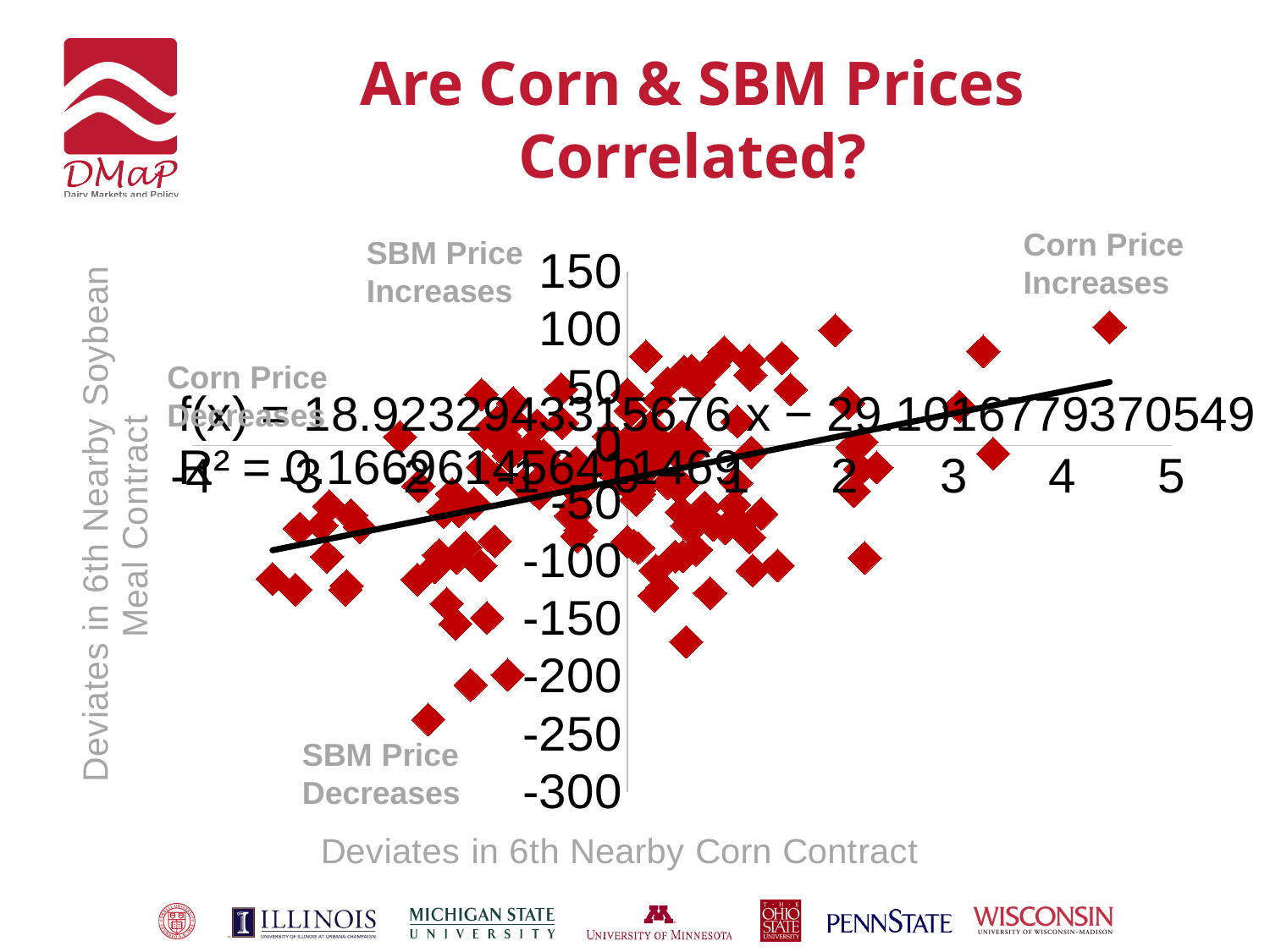
Is the trendline value at x = 4 greater or less than 0? greater Does the fitted trendline on the chart rise or fall as the x-axis value increases? rise Is the trendline value at x = -4 greater or less than 0? less What is the highest tick value shown on the horizontal axis of the chart? 5 What is the slope coefficient of x in the trendline equation displayed on the chart? 18.9232943315676 What is the label of the horizontal axis of the chart? Deviates in 6th Nearby Corn Contract What kind of chart is shown on the slide? scatter chart What is the lowest tick value shown on the horizontal axis of the chart? -4 Is the slope of the trendline on the chart positive or negative? positive What is the title of the chart on the slide? Are Corn & SBM Prices Correlated? What is the highest tick value shown on the vertical axis of the chart? 150 What is the lowest tick value shown on the vertical axis of the chart? -300